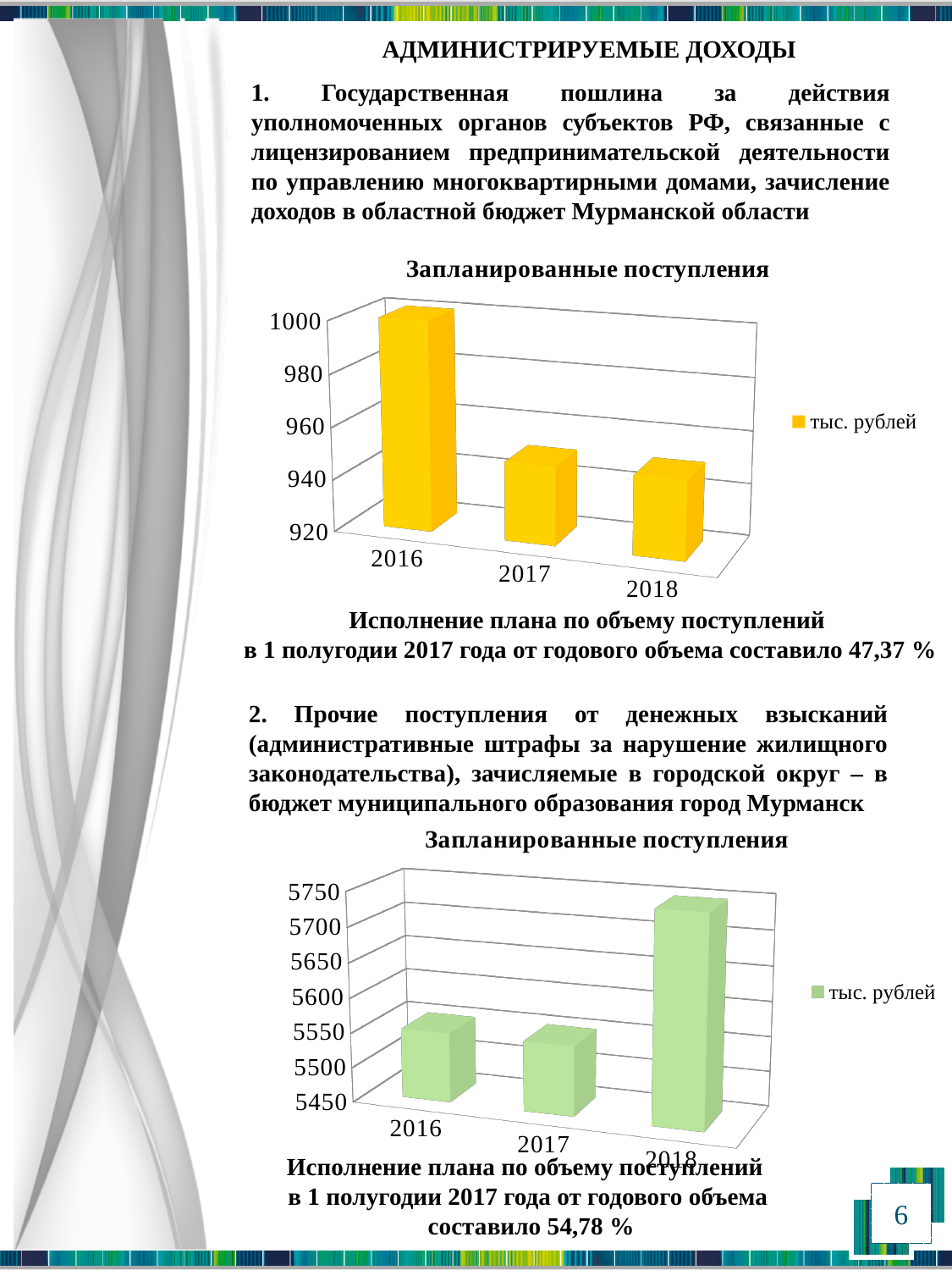
In the top chart (yellow bars), is the value for 2016 greater or less than 980? greater In the bottom chart (green bars), is the value for 2016 greater or less than 5600? less In the top chart (yellow bars), which year has the highest planned receipts? 2016 How many years are shown on the x axis of the top chart? 3 What kind of chart is the top chart on the slide? bar chart What is the legend entry shown in the bottom chart? тыс. рублей How many series does the legend of the top chart list? 1 In the top chart (yellow bars), is the value for 2016 larger than the value for 2018? yes In the bottom chart (green bars), is the value for 2018 greater or less than 5650? greater In the bottom chart (green bars), which is larger, the value for 2017 or the value for 2018? 2018 In the bottom chart (green bars), which year has the highest planned receipts? 2018